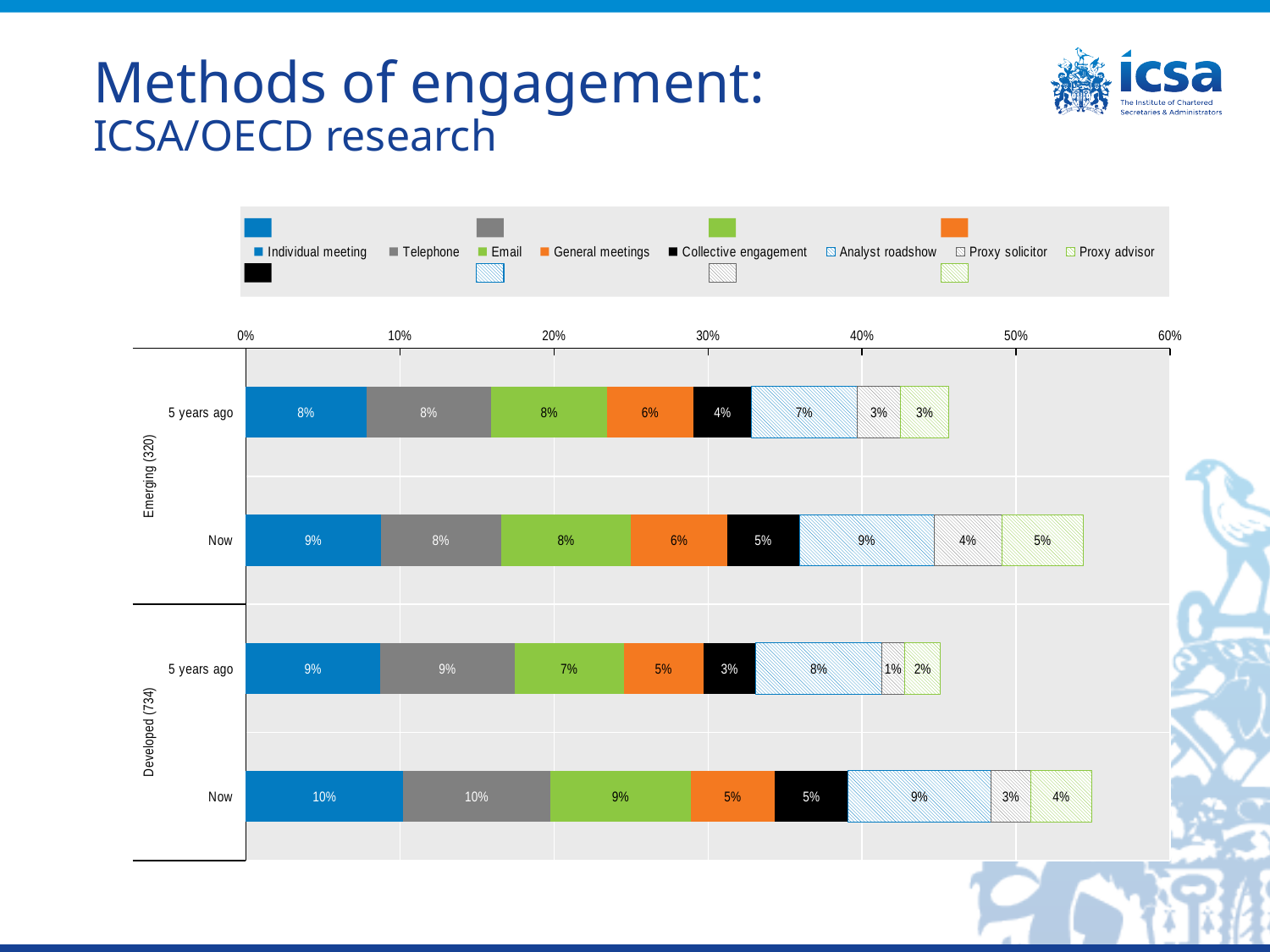
What is the difference between the Proxy advisor values for Emerging (320) Now and Emerging (320) 5 years ago? 2% What is the total of the Developed (734) 5 years ago stacked bar? 44% What is the value for Analyst roadshow in the Emerging (320) Now bar? 9% What is the total of the Emerging (320) Now stacked bar? 54% What is the value for Proxy solicitor in the Developed (734) 5 years ago bar? 1% What is the value for Collective engagement in the Emerging (320) 5 years ago bar? 4% What kind of chart is shown on the slide? Stacked bar chart Is the total length of the Developed (734) Now bar greater or less than 50%? greater What is the value for Individual meeting in the Developed (734) Now bar? 10% How many series does the legend list? 8 Which is larger: the Email value for Developed (734) Now or for Developed (734) 5 years ago? Developed (734) Now How many bars are plotted in the chart? 4